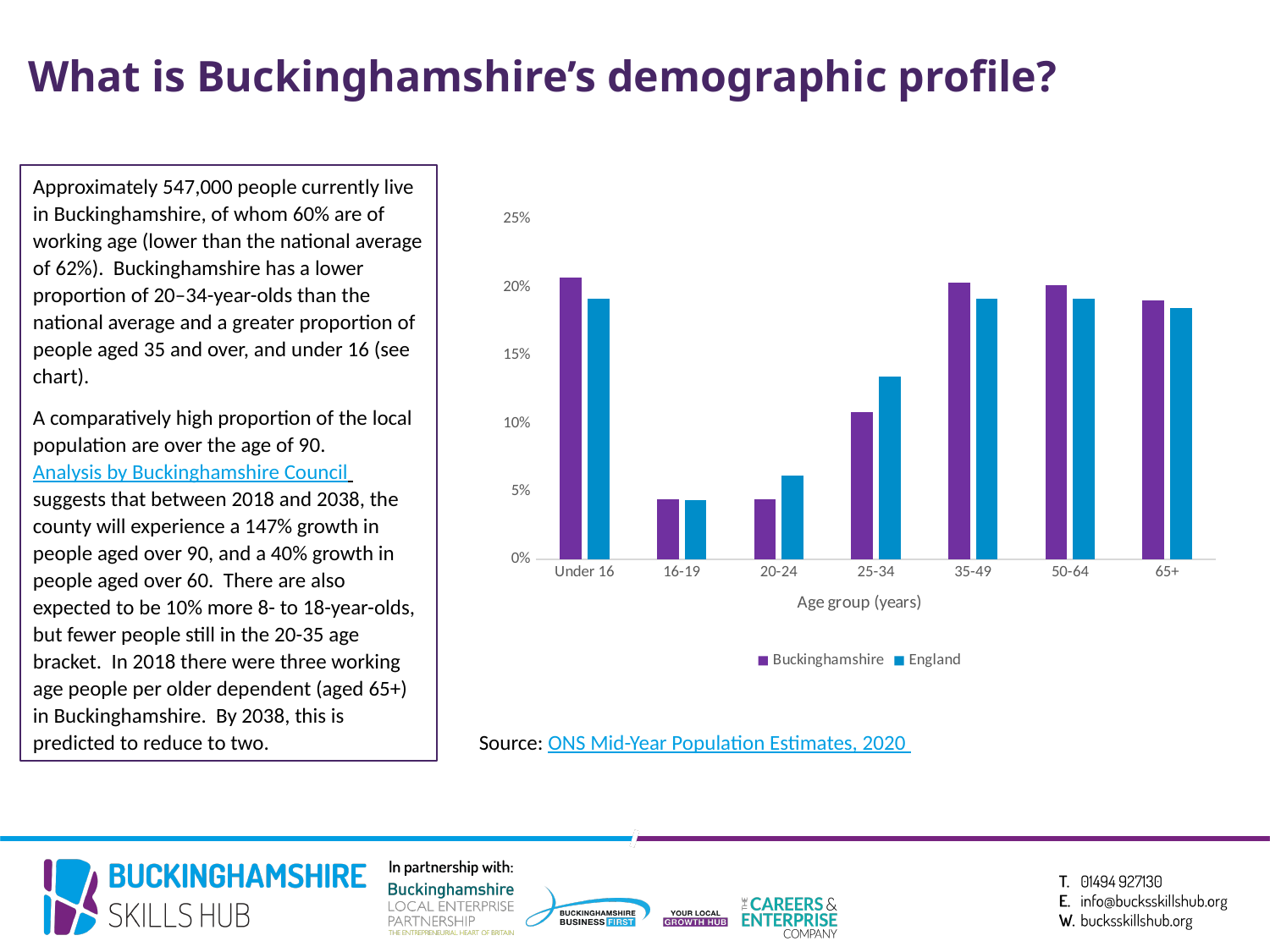
Which series is shown in purple in the chart? Buckinghamshire What kind of chart is shown on the slide? bar chart How many age groups are shown on the x axis of the chart? 7 How many series does the chart's legend list? 2 For the 25-34 age group, which is larger: the Buckinghamshire value or the England value? England Is the Buckinghamshire value for the 16-19 age group greater or less than 5%? less Which age group has the lowest value for England? 16-19 Is the England value for the 25-34 age group greater or less than 10%? greater For the Under 16 age group, which is larger: the Buckinghamshire value or the England value? Buckinghamshire Is the England value for the 65+ age group greater or less than 20%? less For the 20-24 age group, which is larger: the Buckinghamshire value or the England value? England What is the title of the x axis of the chart? Age group (years)